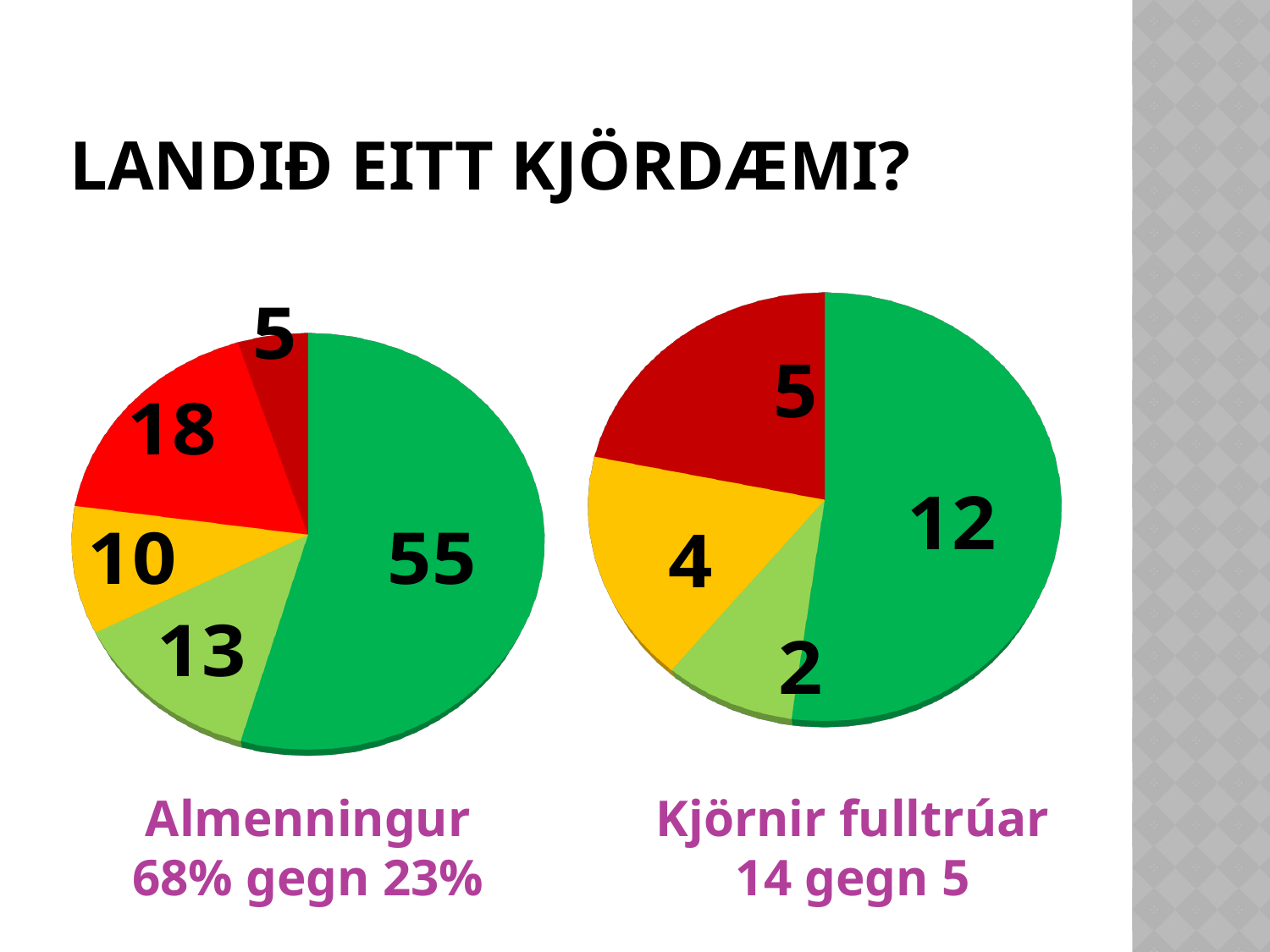
In the Kjörnir fulltrúar pie chart, what value is shown on the dark red slice? 5 In the Almenningur pie chart, what is the difference between the dark green slice (55) and the light green slice (13)? 42 In the Almenningur pie chart, what value is shown on the bright red slice? 18 In the Kjörnir fulltrúar pie chart, which is larger: the yellow slice or the dark red slice? the dark red slice In the Kjörnir fulltrúar pie chart, what is the value of the largest slice? 12 What type of chart is used on this slide? pie chart How many slices does the Almenningur pie chart have? 5 In the Kjörnir fulltrúar pie chart, what is the value of the smallest slice? 2 How many slices does the Kjörnir fulltrúar pie chart have? 4 In the Almenningur pie chart, what is the value of the largest slice? 55 In the Almenningur pie chart, what is the value of the smallest slice? 5 In the Almenningur pie chart, what value is shown on the yellow slice? 10